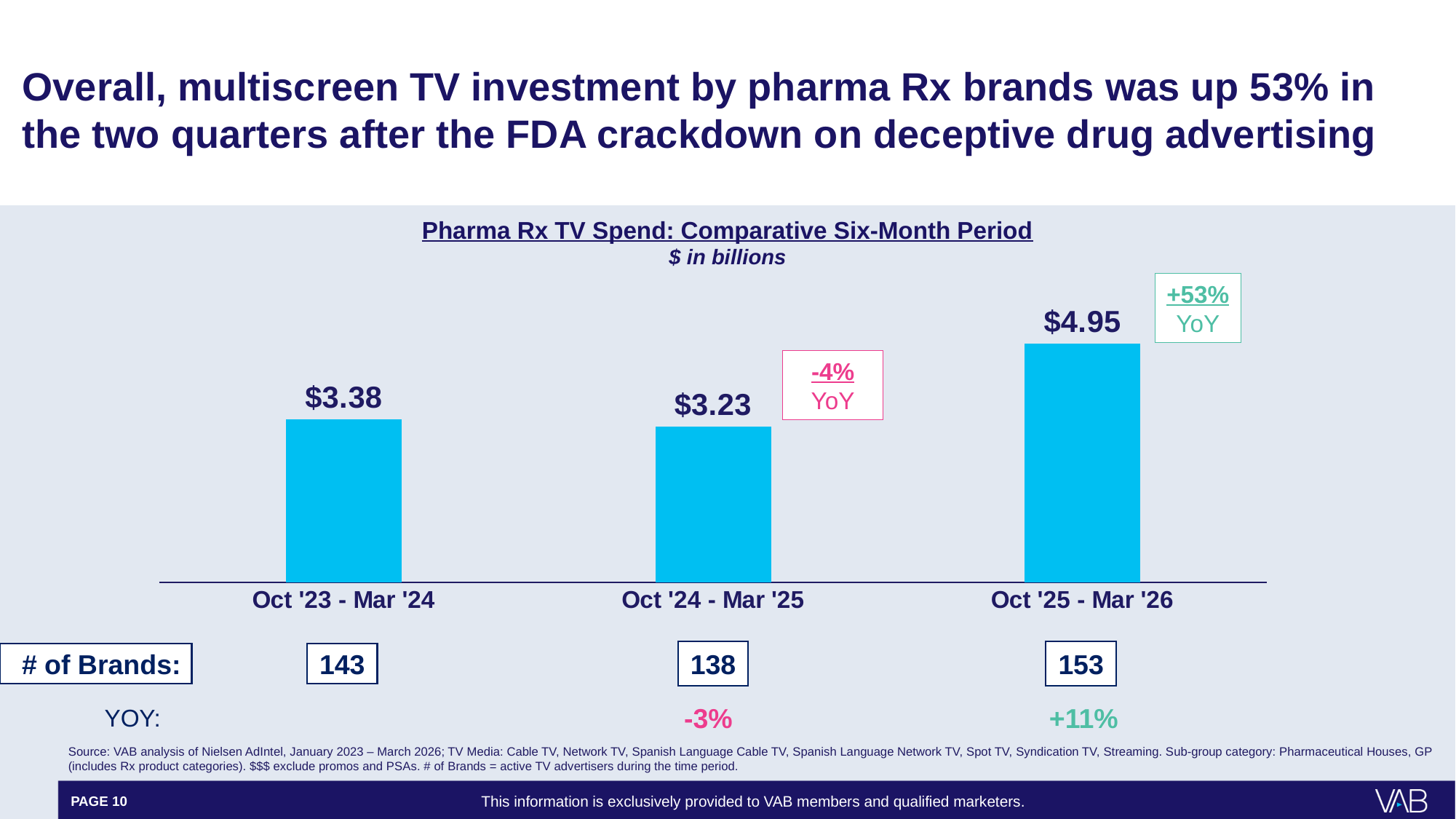
Which period has the larger TV spend, Oct '23 - Mar '24 or Oct '24 - Mar '25? Oct '23 - Mar '24 What kind of chart is shown on the slide? Bar chart What is the Pharma Rx TV spend for Oct '23 - Mar '24? $3.38 What is the YoY change in TV spend shown for Oct '25 - Mar '26? +53% How many brands are listed for the Oct '25 - Mar '26 period? 153 What is the difference in TV spend between Oct '25 - Mar '26 and Oct '24 - Mar '25? $1.72 Which period has the highest Pharma Rx TV spend? Oct '25 - Mar '26 What unit is the chart's spend expressed in, according to the subtitle? $ in billions What is the Pharma Rx TV spend for Oct '24 - Mar '25? $3.23 How many periods are shown in the chart? 3 Which period has the lowest Pharma Rx TV spend? Oct '24 - Mar '25 What is the Pharma Rx TV spend for Oct '25 - Mar '26? $4.95